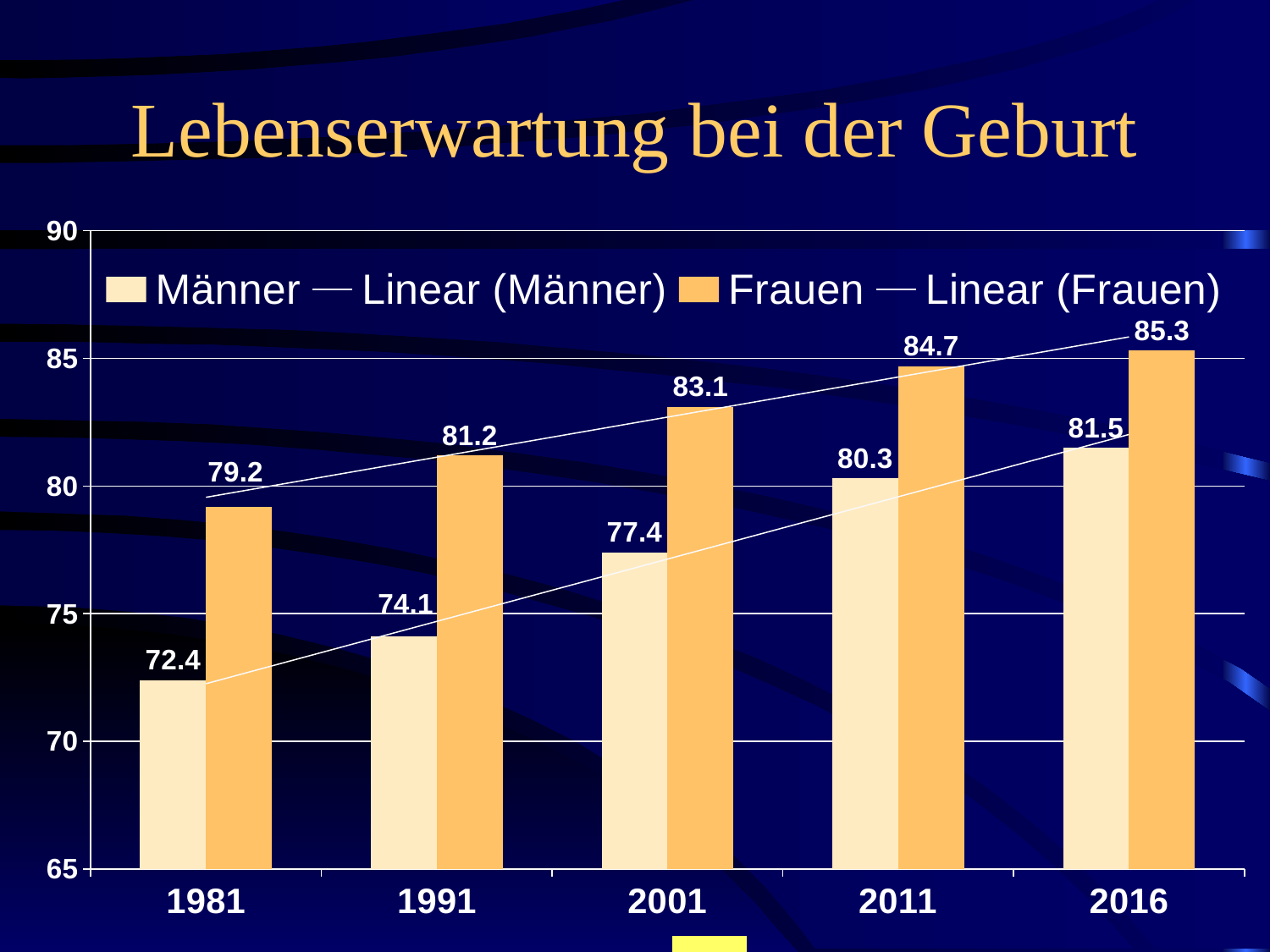
In which year is the value for Frauen highest? 2016 In which year is the value for Männer lowest? 1981 What is the value for Männer in 1981? 72.4 What is the difference between the Männer values in 1991 and 2001? 3.3 What is the difference between the Frauen and Männer values in 2016? 3.8 How many entries does the legend list? 4 Do the Männer values rise or fall from 1981 to 2016? rise What is the value for Frauen in 2001? 83.1 What is the value for Frauen in 2011? 84.7 How many years are shown on the x axis? 5 What kind of chart is shown? bar chart Which is larger, the Männer value in 2016 or the Frauen value in 1991? Männer in 2016